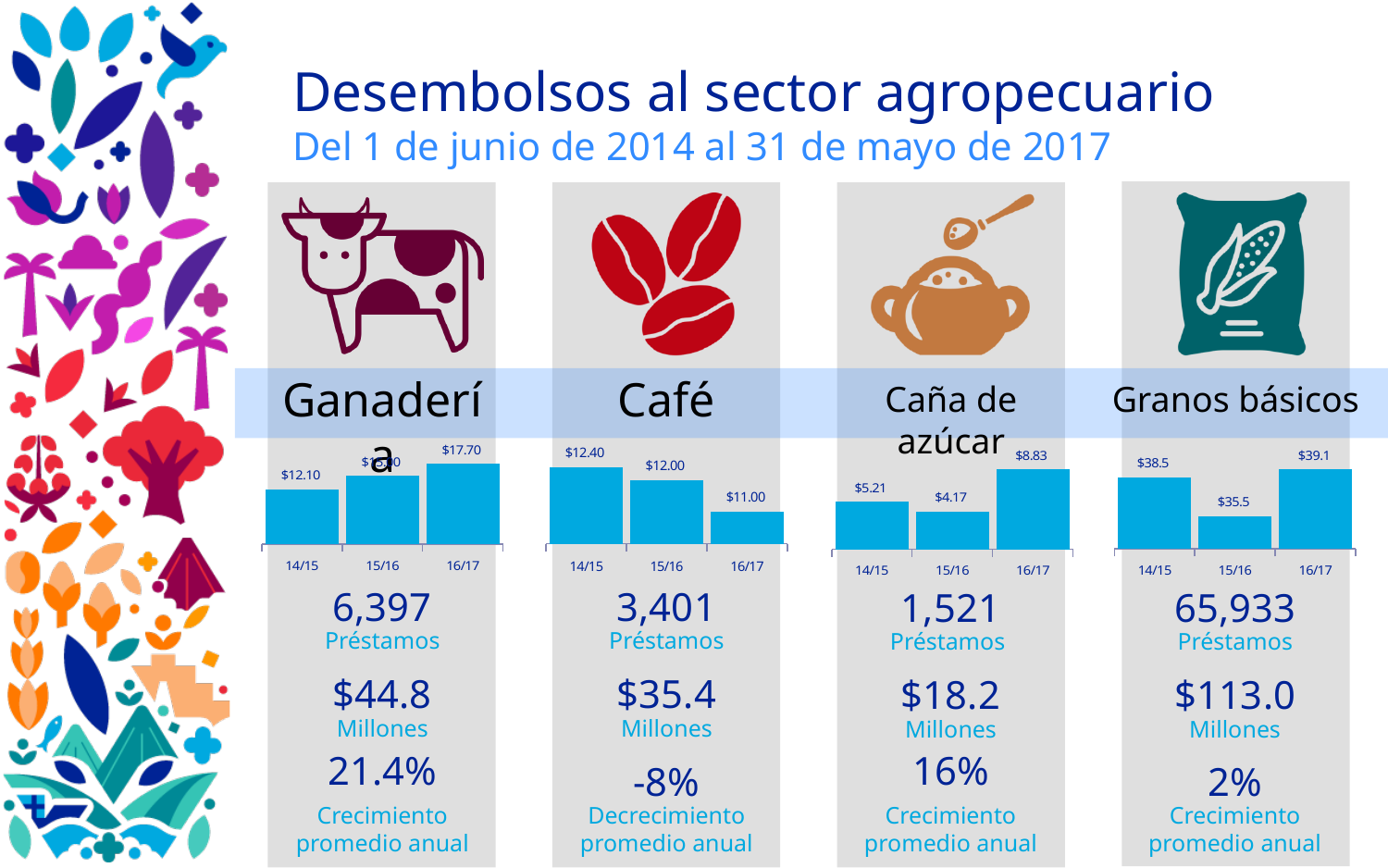
In the Caña de azúcar chart, which period has the lowest value? 15/16 In the Ganadería chart, what is the value for 14/15? $12.10 In the Café chart, what is the value for 16/17? $11.00 In the Caña de azúcar chart, what is the difference between the 16/17 and 14/15 values? $3.62 In the Granos básicos chart, which period has the highest value? 16/17 In the Café chart, what is the value for 14/15? $12.40 In the Granos básicos chart, what is the value for 15/16? $35.5 What type of chart is used for Granos básicos? bar chart In the Café chart, what is the difference between the 14/15 and 16/17 values? $1.40 How many bars does the Ganadería chart have? 3 In the Café chart, do the values rise or fall from 14/15 to 16/17? fall In the Caña de azúcar chart, what is the value for 16/17? $8.83